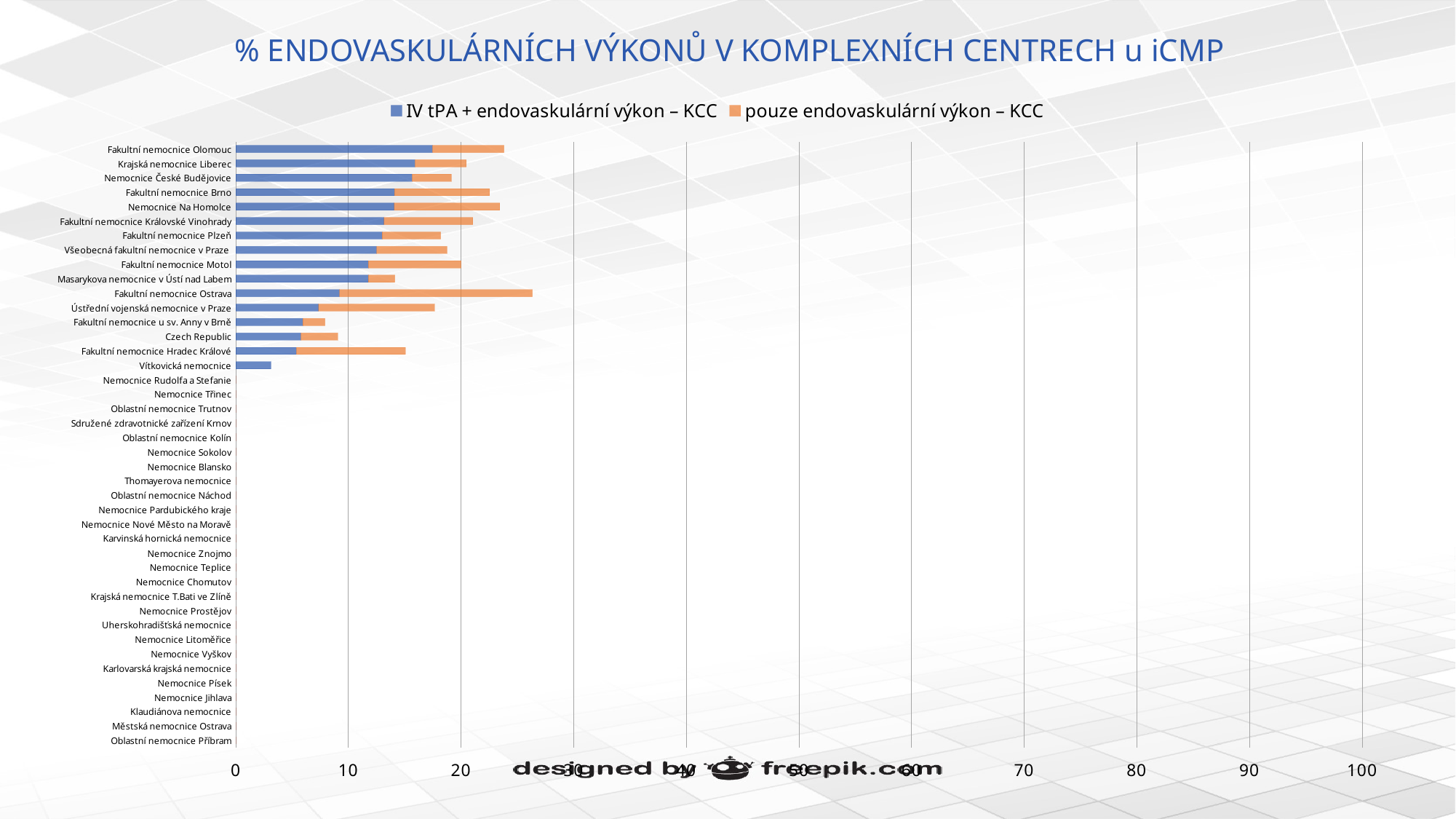
Which hospital has the longest total stacked bar? Fakultní nemocnice Ostrava Which has the larger total stacked bar: Fakultní nemocnice Ostrava or Vítkovická nemocnice? Fakultní nemocnice Ostrava What is the title of the chart? % ENDOVASKULÁRNÍCH VÝKONŮ V KOMPLEXNÍCH CENTRECH u iCMP Is the total stacked bar for Fakultní nemocnice Ostrava greater or less than 20? greater What are the two series named in the legend? IV tPA + endovaskulární výkon – KCC; pouze endovaskulární výkon – KCC Is the 'IV tPA + endovaskulární výkon – KCC' value for Fakultní nemocnice Olomouc greater or less than 10? greater Which has the larger 'IV tPA + endovaskulární výkon – KCC' value: Fakultní nemocnice Olomouc or Fakultní nemocnice Hradec Králové? Fakultní nemocnice Olomouc How many series does the legend list? 2 Is the value for Vítkovická nemocnice greater or less than 10? less How many hospitals (categories) are listed on the vertical axis? 42 What kind of chart is shown on the slide? bar chart